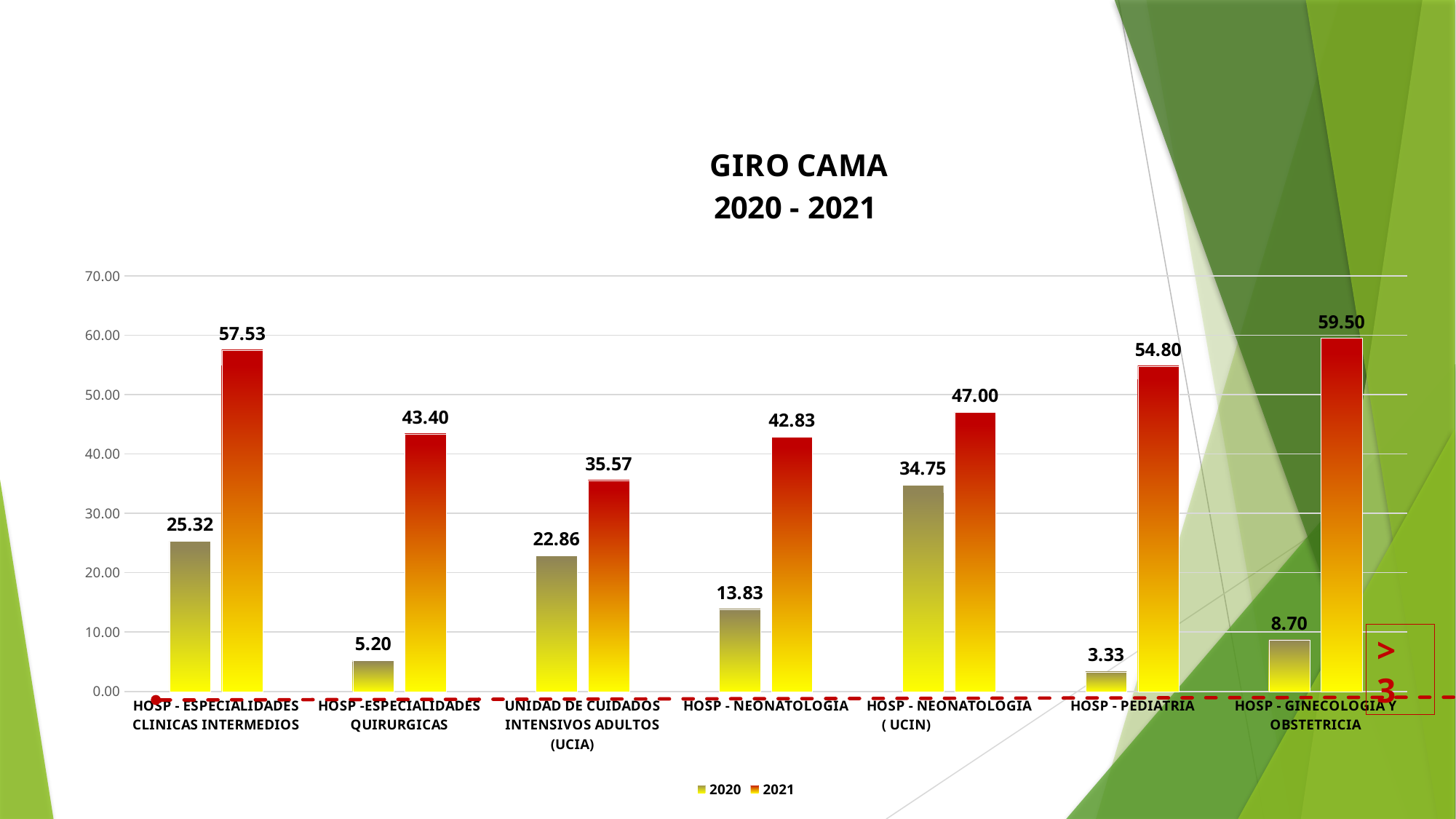
How many categories are shown on the x axis? 7 What is the difference between the 2021 and 2020 values for HOSP - ESPECIALIDADES CLINICAS INTERMEDIOS? 32.21 What is the 2021 value for HOSP - NEONATOLOGIA ( UCIN)? 47.00 Which category has the highest 2021 value? HOSP - GINECOLOGIA Y OBSTETRICIA Is the 2021 value for HOSP - ESPECIALIDADES QUIRURGICAS greater or less than 40.00? greater Which is larger: the 2020 value for HOSP - NEONATOLOGIA or the 2020 value for HOSP - NEONATOLOGIA ( UCIN)? HOSP - NEONATOLOGIA ( UCIN) What is the title of the chart? GIRO CAMA 2020 - 2021 What is the 2020 value for UNIDAD DE CUIDADOS INTENSIVOS ADULTOS (UCIA)? 22.86 Which category has the lowest 2020 value? HOSP - PEDIATRIA What is the 2021 value for HOSP - PEDIATRIA? 54.80 What kind of chart is shown on the slide? bar chart How many series does the legend list? 2